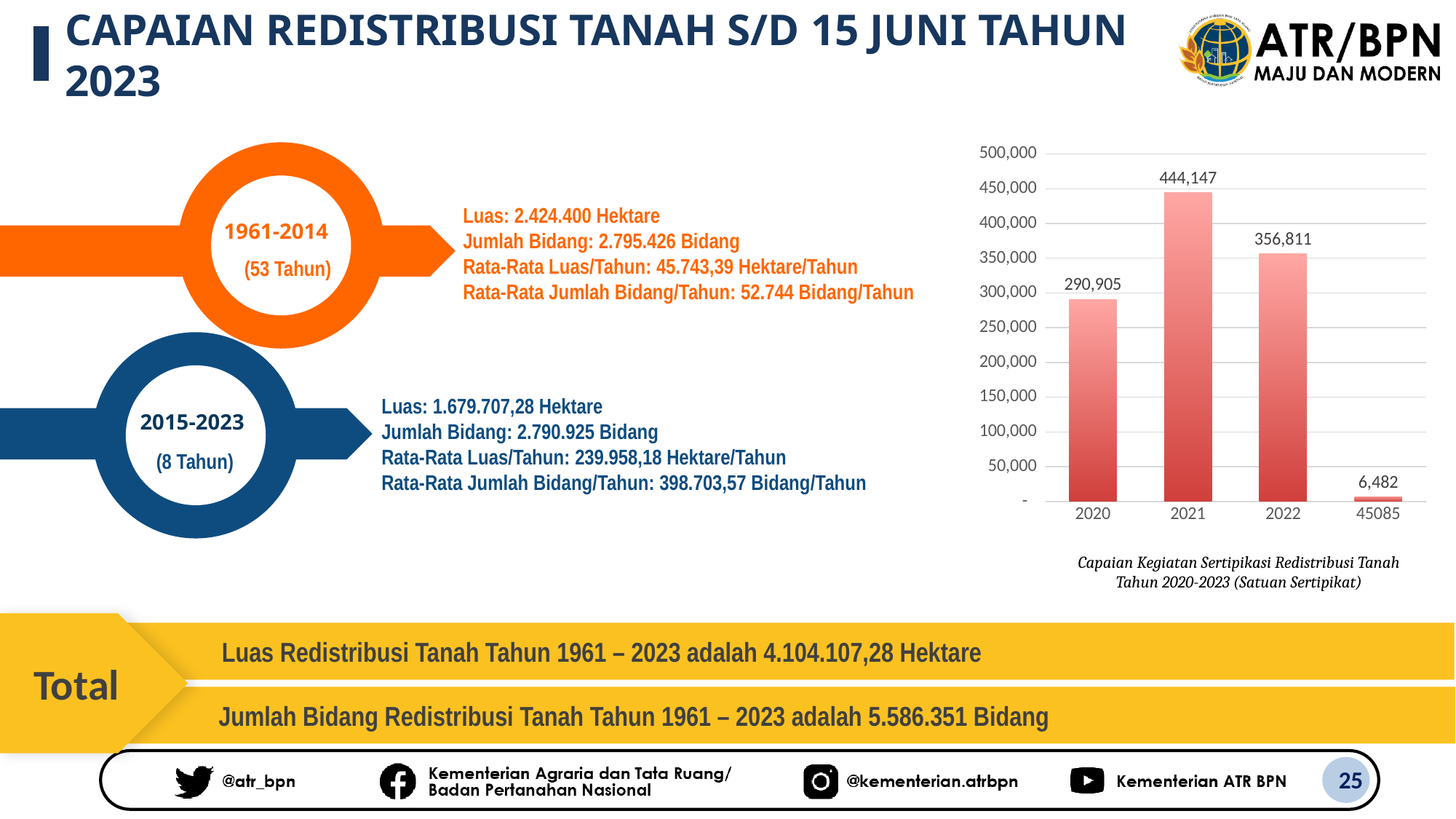
What type of chart is shown on the slide? Bar chart Which category has the lowest value in the bar chart? 45085 What is the value shown for the last bar (labelled 45085) in the bar chart? 6,482 Which category has the highest value in the bar chart? 2021 What is the value for 2022 in the bar chart? 356,811 What is the difference between the values for 2022 and 2020 in the bar chart? 65,906 Which is larger in the bar chart, the value for 2020 or the value for 2022? 2022 What is the difference between the values for 2021 and 2022 in the bar chart? 87,336 What is the caption printed below the bar chart? Capaian Kegiatan Sertipikasi Redistribusi Tanah Tahun 2020-2023 (Satuan Sertipikat) What is the value for 2020 in the bar chart? 290,905 What is the value for 2021 in the bar chart? 444,147 How many bars are shown in the bar chart? 4